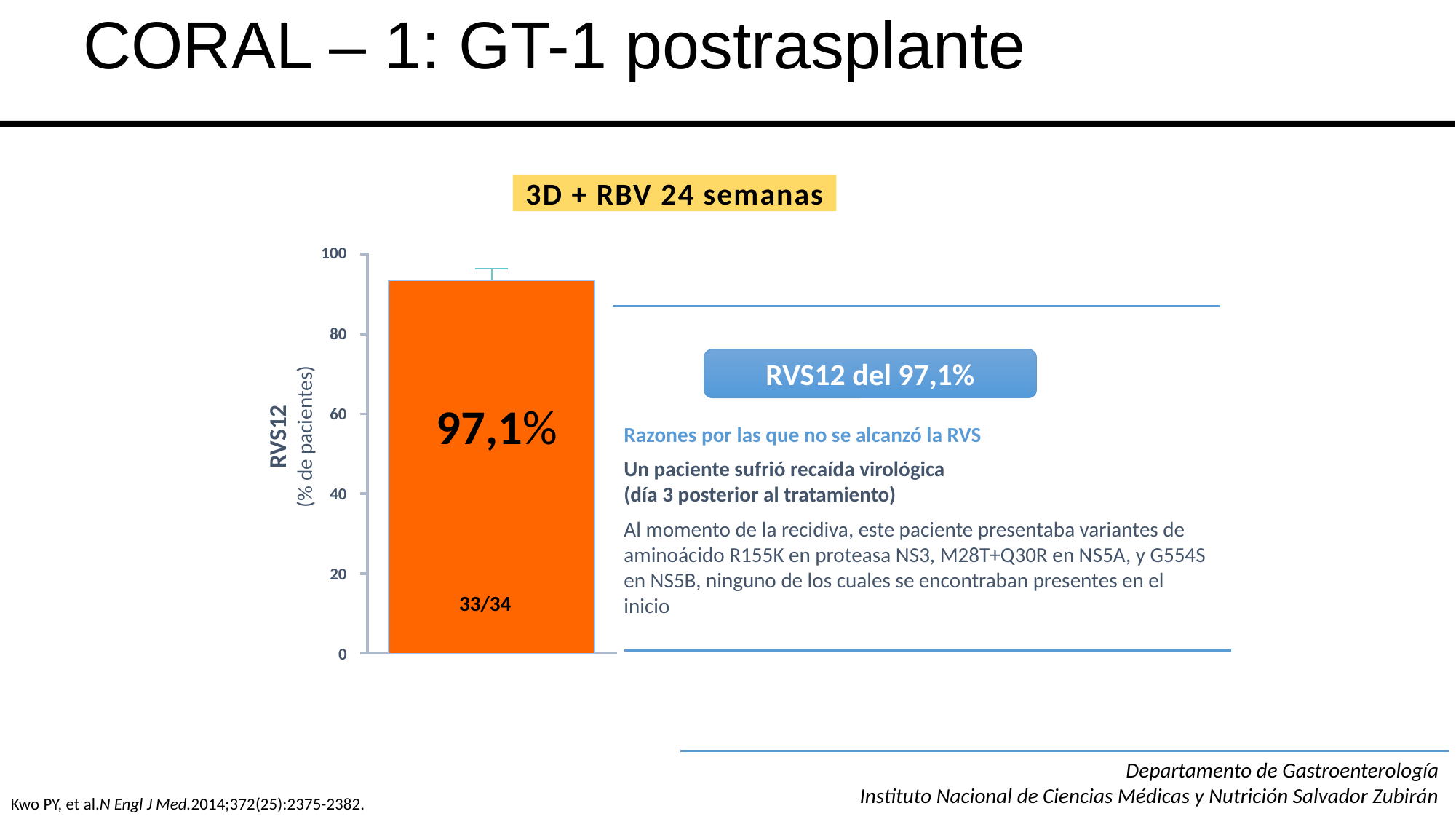
What treatment regimen is the bar in the chart labelled with? 3D + RBV 24 semanas Is the value for 3D + RBV 24 semanas greater or less than 80? greater What patient fraction is printed on the 3D + RBV 24 semanas bar? 33/34 What is the label of the y-axis of the chart? RVS12 (% de pacientes) Is the value for 3D + RBV 24 semanas greater or less than 100? less What kind of chart is shown on the slide? bar chart What is the RVS12 value shown for the 3D + RBV 24 semanas bar? 97,1% How many bars does the chart contain? 1 What is the maximum value shown on the y-axis of the chart? 100